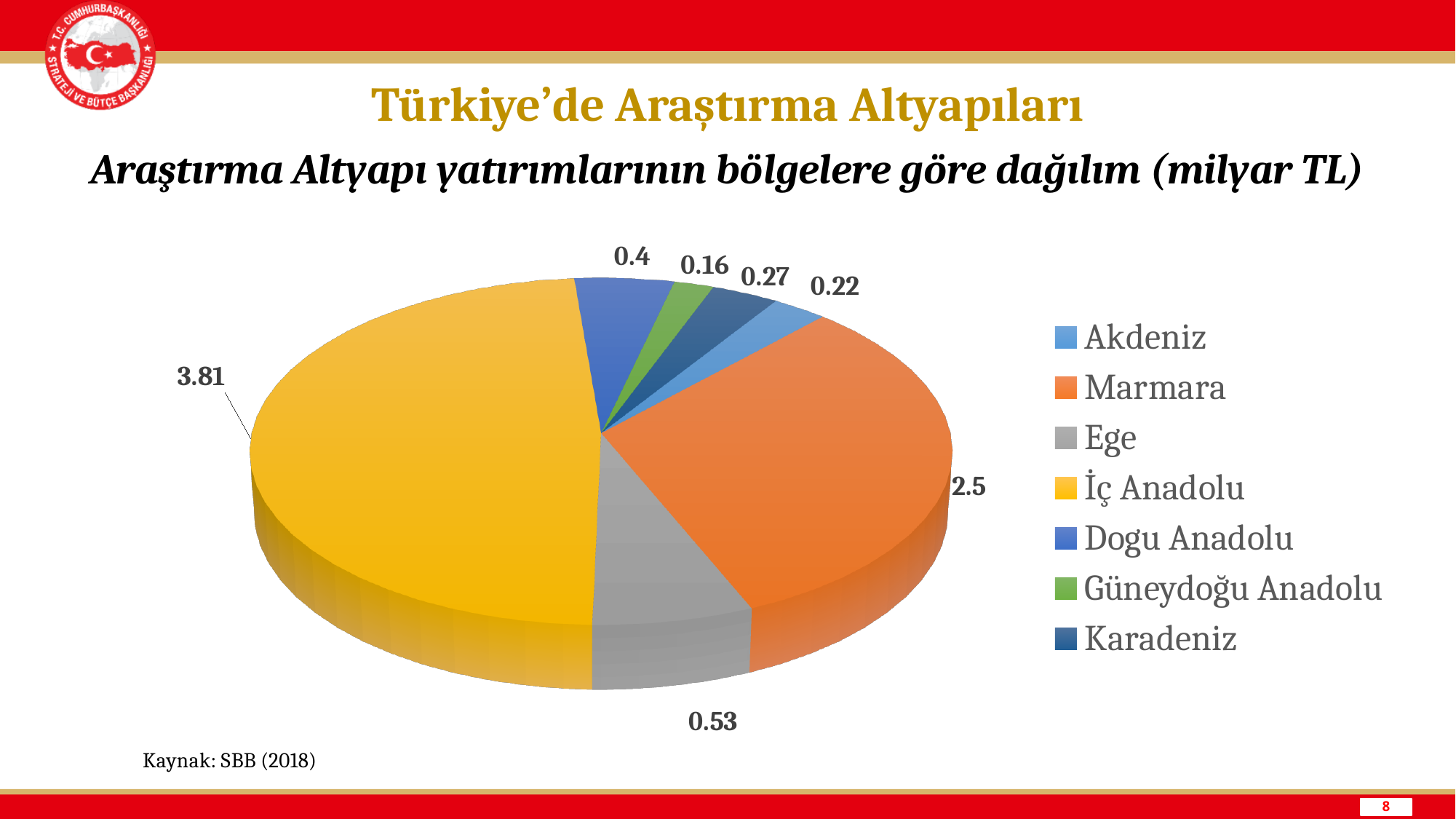
What is the difference between the values for İç Anadolu and Marmara? 1.31 What kind of chart is shown on the slide? Pie chart Which region has the largest slice? İç Anadolu How many regions are shown in the pie chart? 7 What is the value for Karadeniz? 0.27 What is the value for İç Anadolu? 3.81 What is the value for Güneydoğu Anadolu? 0.16 Which is larger, the value for Dogu Anadolu or the value for Akdeniz? Dogu Anadolu What is the value for Ege? 0.53 Which region has the smallest slice? Güneydoğu Anadolu What colour is the Marmara slice? Orange What is the value for Marmara? 2.5